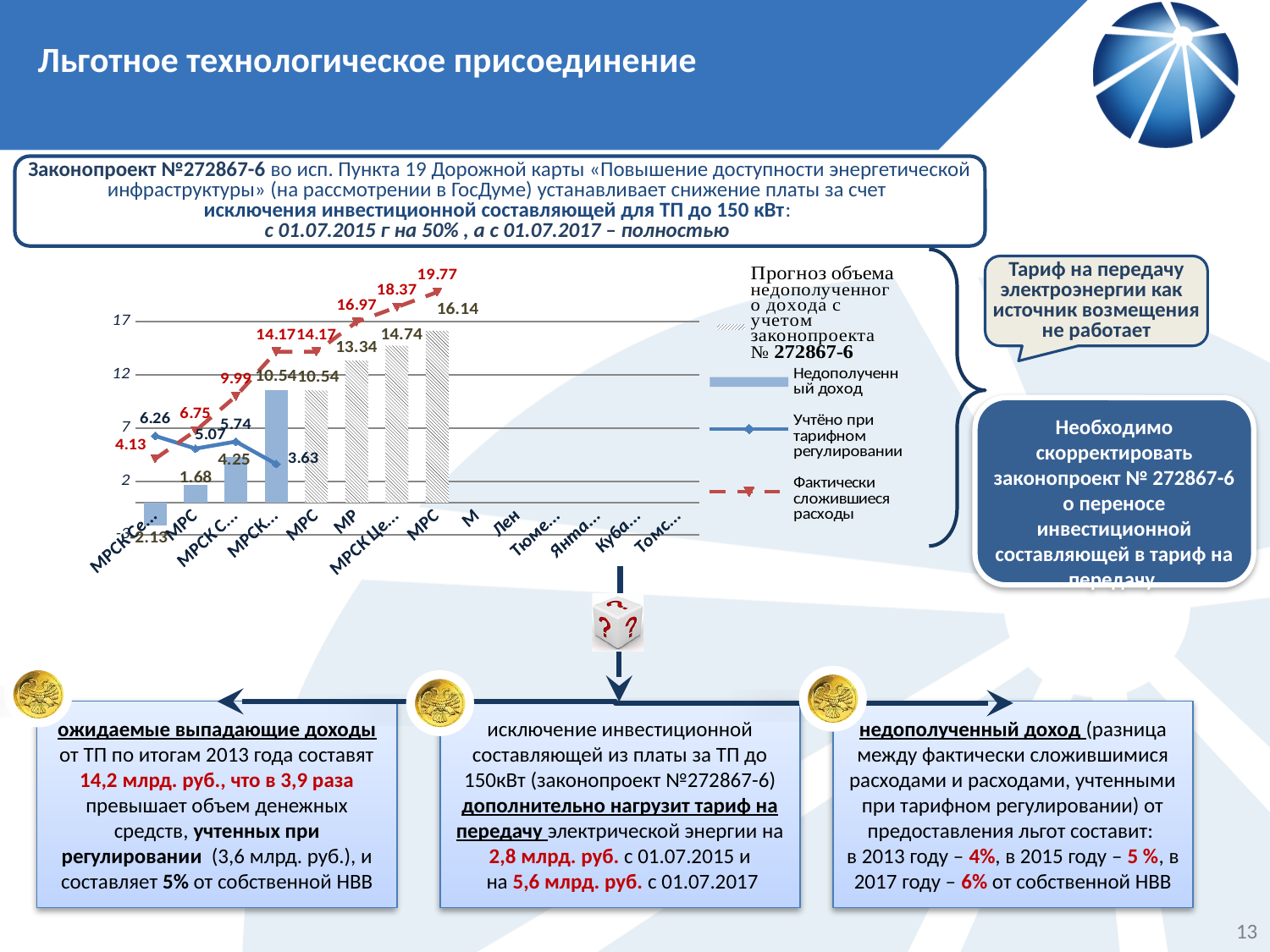
Do the values of the dashed red line (Фактически сложившиеся расходы) rise or fall from left to right? Rise Which is larger: the first labelled value on the solid blue line (6.26) or the first labelled value on the dashed red line (4.13)? 6.26 (solid blue line) Is the highest value on the dashed red line greater or less than 17? greater What is the difference between the highest and lowest labelled values on the dashed red line (19.77 and 4.13)? 15.64 What is the lowest value labelled on the dashed red line (Фактически сложившиеся расходы)? 4.13 Which legend entry is shown with a dashed red line? Фактически сложившиеся расходы What is the highest value labelled on the dashed red line (Фактически сложившиеся расходы)? 19.77 How many series does the chart legend list? 4 Which legend entry is shown with solid light-blue bars? Недополученный доход Do the values of the solid blue line (Учтёно при тарифном регулировании) rise or fall from left to right? Fall What kind of chart is shown on the slide? Combined bar and line chart What is the highest value labelled on the hatched bars (Прогноз объема недополученного дохода)? 16.14